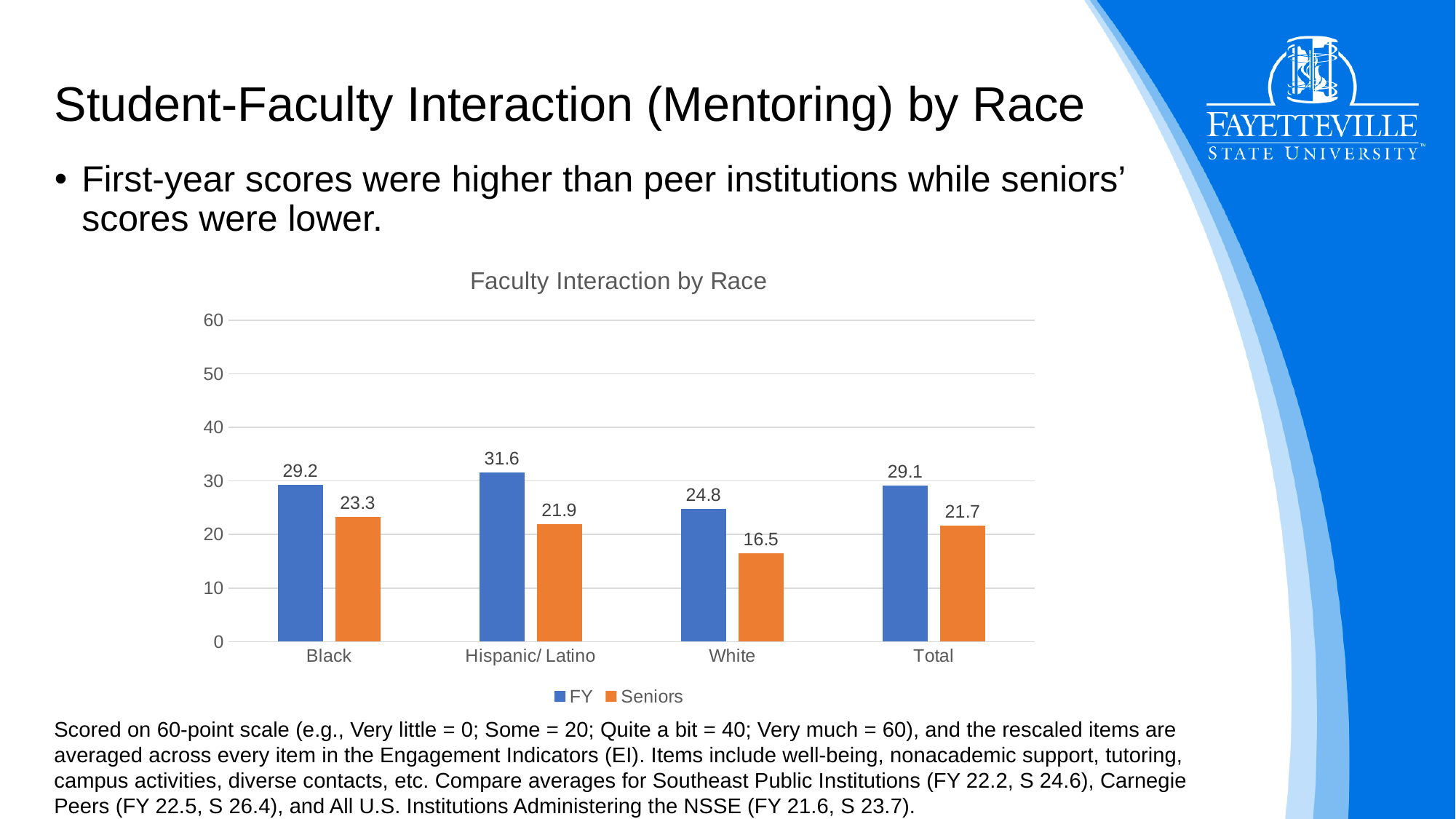
What is the Seniors value for Total? 21.7 What is the Seniors value for White? 16.5 Which category has the lowest Seniors value? White What is the FY value for Hispanic/ Latino? 31.6 Which category has the highest FY value? Hispanic/ Latino How many series does the legend list? 2 How many categories are shown on the x axis? 4 What is the difference between the FY and Seniors values for Black? 5.9 What is the title of the chart? Faculty Interaction by Race Which is larger, the FY value for White or the Seniors value for Black? FY value for White Is the FY value for Hispanic/ Latino greater or less than 30? greater What kind of chart is shown? bar chart